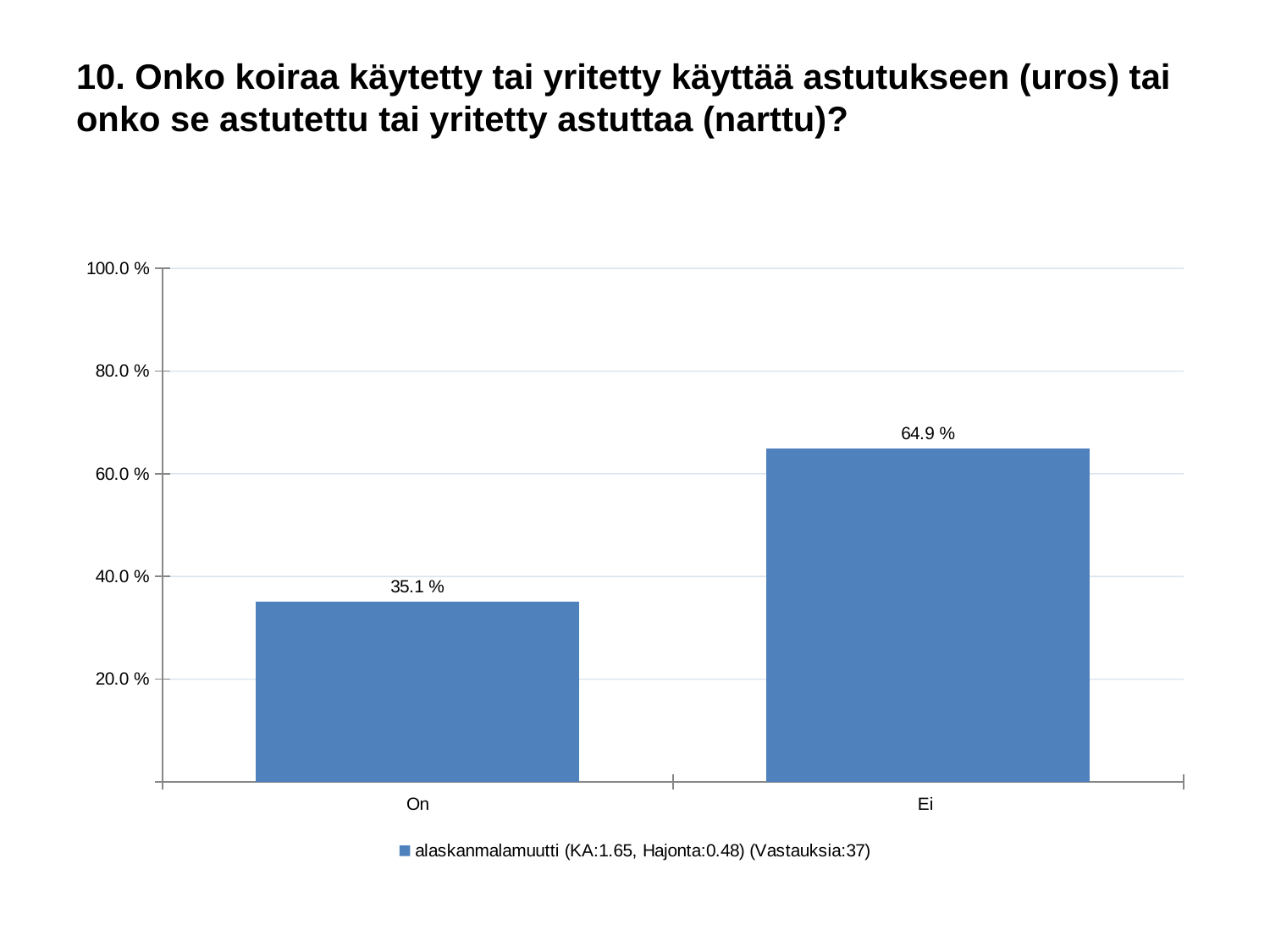
How many series does the legend list? 1 What kind of chart is shown on the slide? bar chart Is the value for "On" greater or less than 40.0 %? less Which category has the lowest value? On Which category has the highest value? Ei What is the difference between the values for "Ei" and "On"? 29.8 % Is the value for "Ei" greater or less than 60.0 %? greater Which is larger, the value for "On" or the value for "Ei"? Ei How many categories are shown on the x axis? 2 What is the value for "Ei"? 64.9 % How many responses (Vastauksia) does the legend entry report? 37 What is the value for "On"? 35.1 %